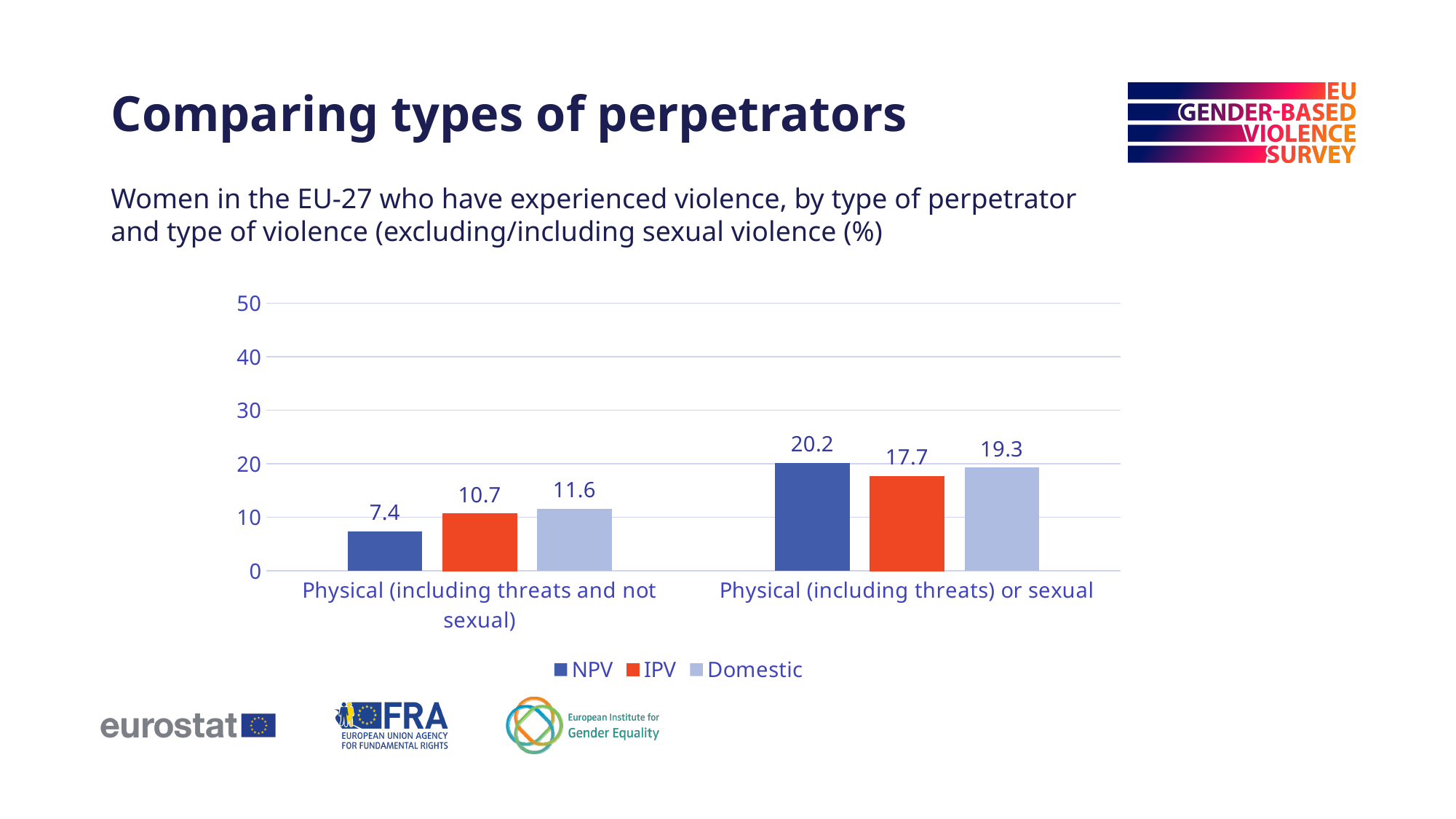
How many series does the legend list? 3 What kind of chart is shown on the slide? Bar chart Which series has the lowest value for 'Physical (including threats and not sexual)'? NPV Which is larger: the IPV value for 'Physical (including threats and not sexual)' or the IPV value for 'Physical (including threats) or sexual'? Physical (including threats) or sexual What is the IPV value for 'Physical (including threats and not sexual)'? 10.7 What is the difference between the Domestic and NPV values for 'Physical (including threats and not sexual)'? 4.2 Which series has the highest value for 'Physical (including threats) or sexual'? NPV What is the Domestic value for 'Physical (including threats) or sexual'? 19.3 Is the NPV value for 'Physical (including threats) or sexual' greater or less than 20? greater What is the NPV value for 'Physical (including threats and not sexual)'? 7.4 How many categories are shown on the x axis? 2 What is the difference between the NPV and IPV values for 'Physical (including threats) or sexual'? 2.5